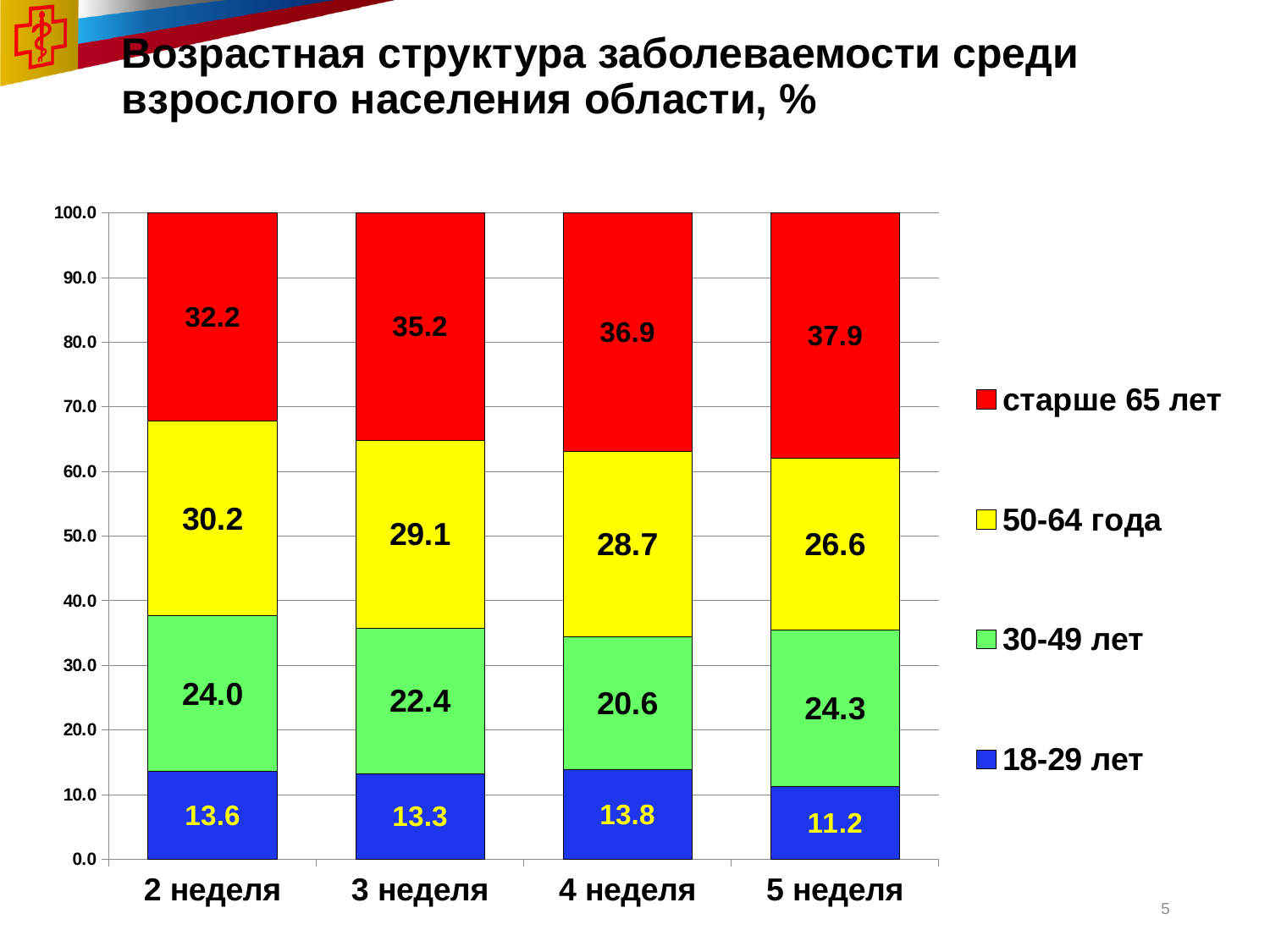
How many weeks (categories) are shown on the x axis? 4 In which week is the "старше 65 лет" value highest? 5 неделя Which is larger: the "30-49 лет" value for "2 неделя" or for "5 неделя"? 5 неделя What kind of chart is shown on the slide? Stacked bar chart What is the total of the stacked bar for "3 неделя"? 100.0 What is the value for "50-64 года" in "2 неделя"? 30.2 Does the "50-64 года" value rise or fall from "2 неделя" to "5 неделя"? Fall What is the value for "18-29 лет" in "5 неделя"? 11.2 What is the difference between the "старше 65 лет" values for "5 неделя" and "2 неделя"? 5.7 In which week is the "30-49 лет" value lowest? 4 неделя How many series does the legend list? 4 What is the value for "старше 65 лет" in "4 неделя"? 36.9